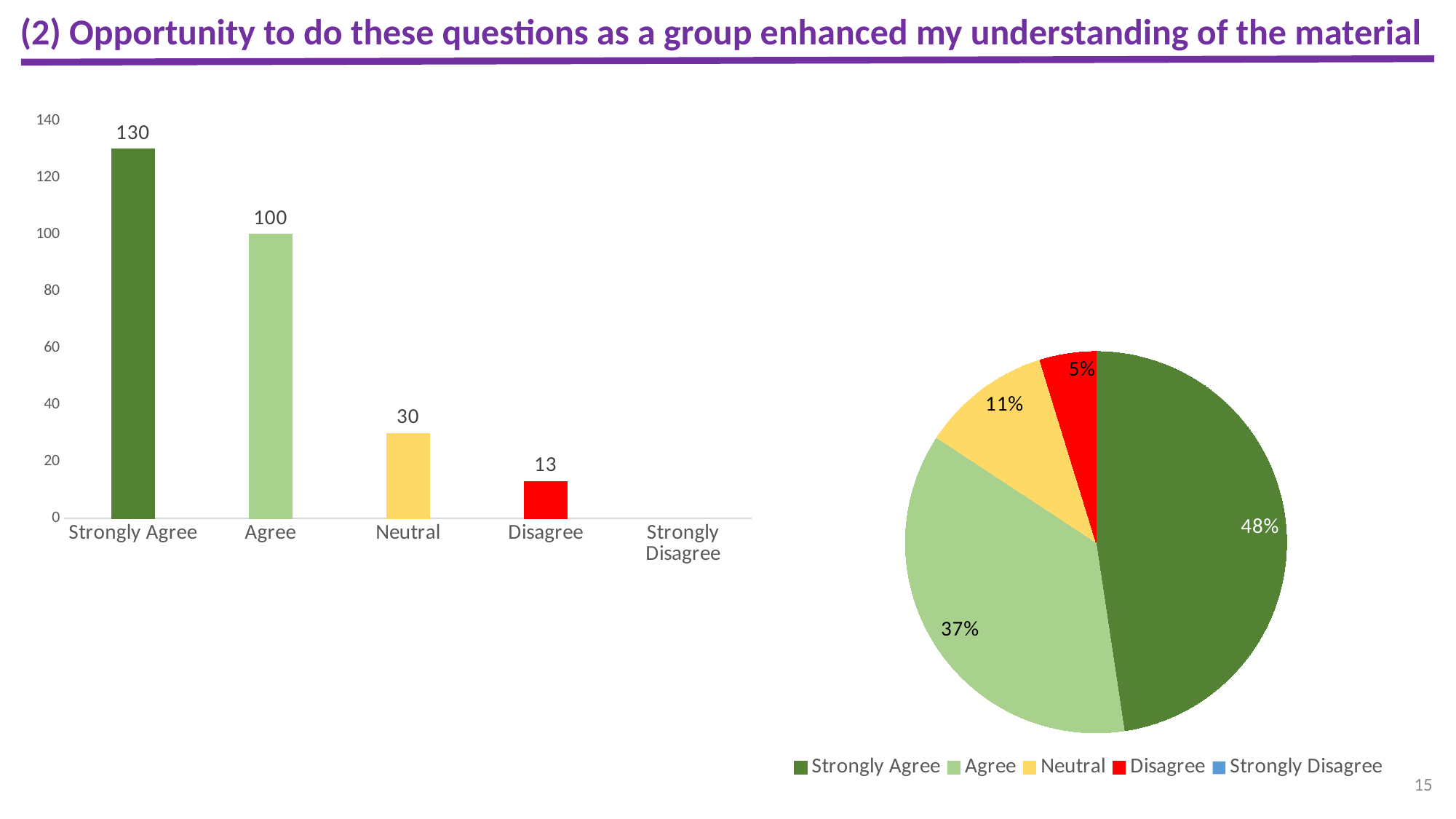
What kind of chart is shown on the left of the slide? bar chart In the bar chart on the left, what is the value for Disagree? 13 In the pie chart on the right, what share does Disagree have? 5% In the pie chart on the right, what share does Agree have? 37% How many entries does the legend of the pie chart on the right list? 5 In the bar chart on the left, which category has the highest value? Strongly Agree In the bar chart on the left, what is the value for Neutral? 30 How many categories are shown on the x axis of the bar chart on the left? 5 In the bar chart on the left, what is the difference between the Strongly Agree and Agree values? 30 In the bar chart on the left, which is larger, the value for Neutral or the value for Disagree? Neutral In the bar chart on the left, what is the value for Strongly Agree? 130 In the pie chart on the right, what share does Strongly Agree have? 48%